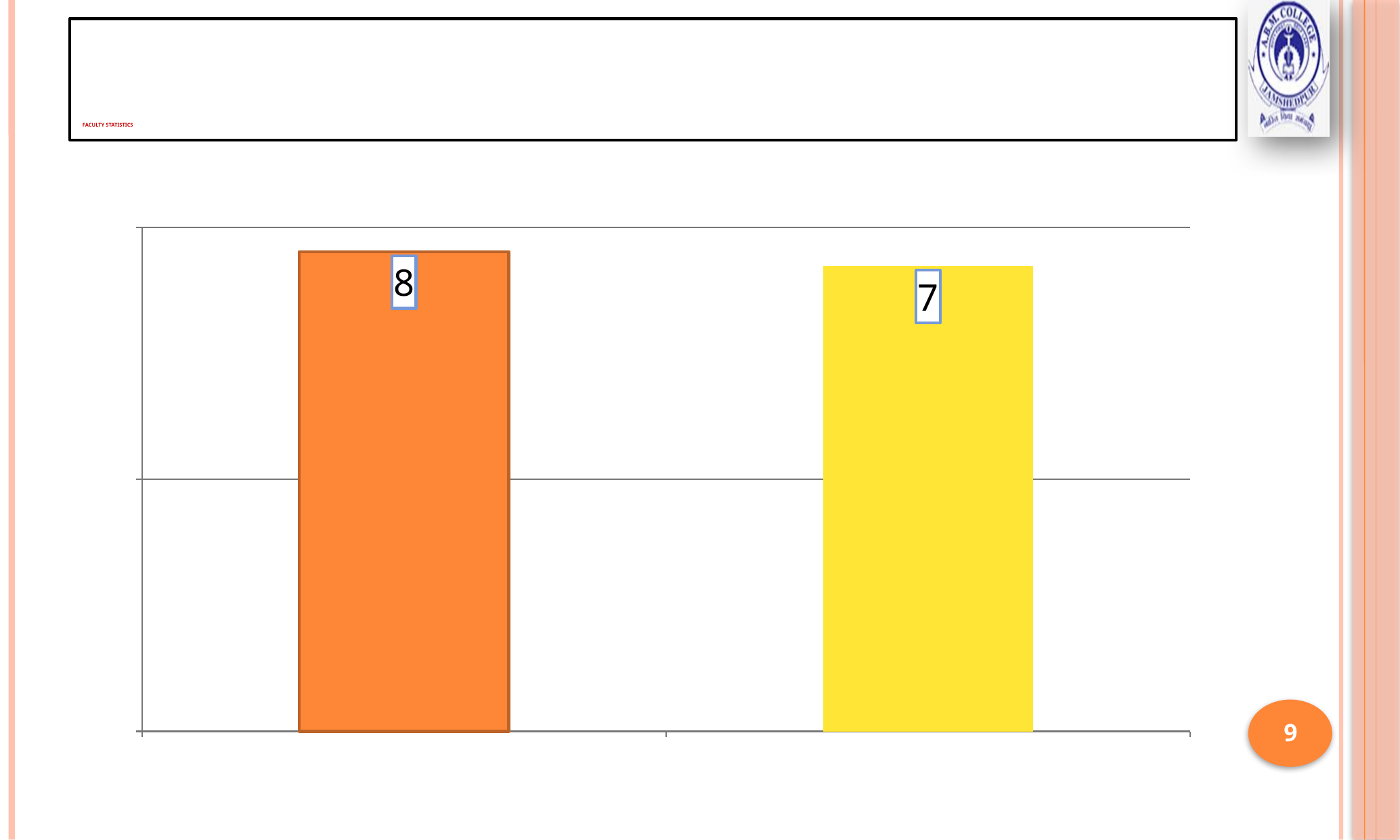
What is the value of the left-hand bar in the chart? 8 What is the total of the two bar values shown in the chart? 15 Which bar shows the lowest value, the left bar or the right bar? the right bar What is the value shown on the orange bar? 8 Do the bar values rise or fall from left to right across the chart? fall How many bars are plotted in the chart? 2 What is the value shown on the yellow bar? 7 What is the value of the right-hand bar in the chart? 7 What colour is the bar with the value 7? yellow What kind of chart is shown on the slide? bar chart Which bar has the higher value, the orange bar or the yellow bar? the orange bar What is the difference between the value of the orange bar and the value of the yellow bar? 1